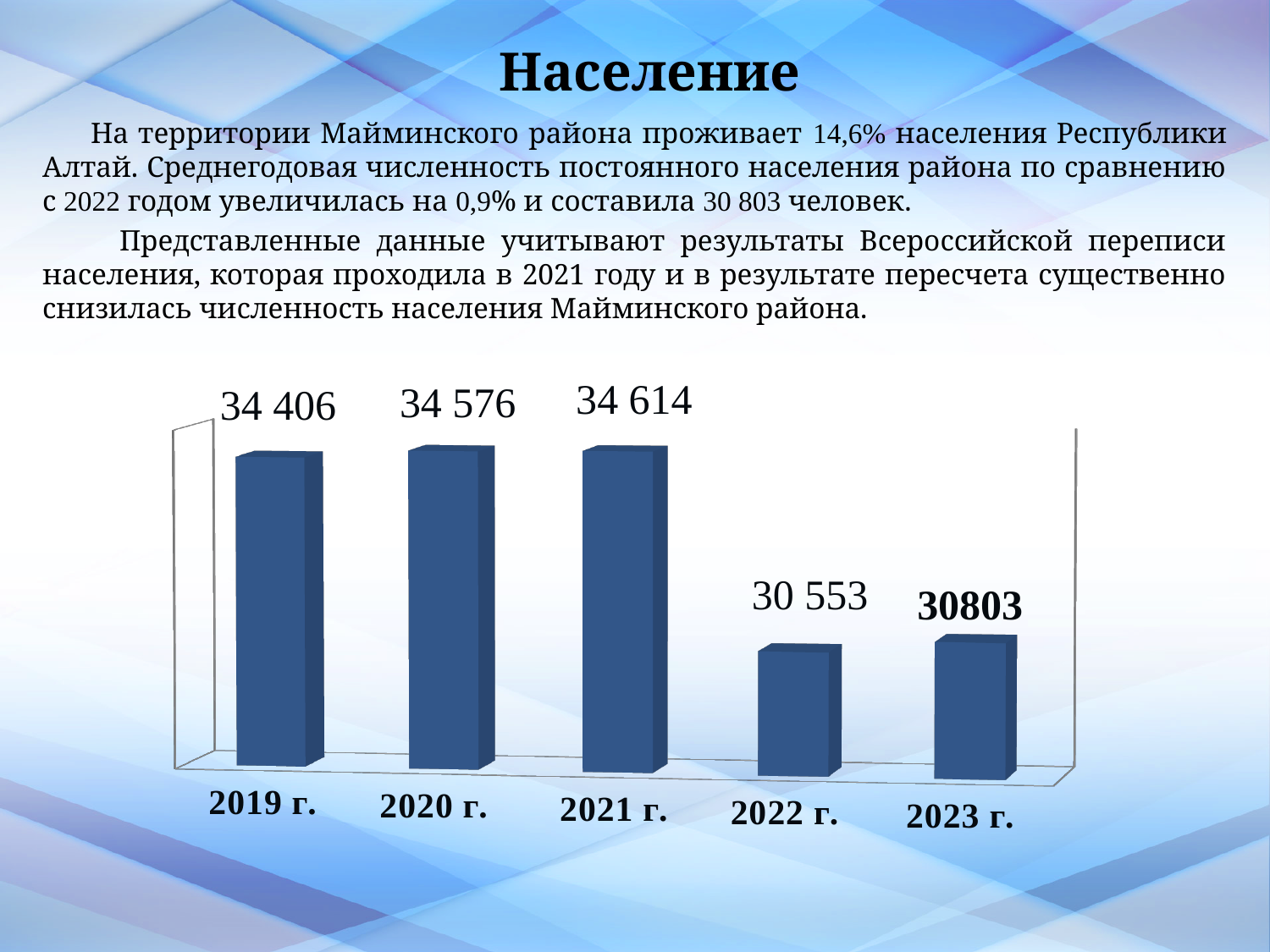
What is the difference between the values for 2021 г. and 2022 г.? 4 061 Which is larger, the value for 2020 г. or the value for 2023 г.? 2020 г. What is the value shown for 2021 г.? 34 614 Do the values rise or fall from 2021 г. to 2022 г.? fall What kind of chart is shown on the slide? bar chart What is the difference between the values for 2023 г. and 2022 г.? 250 Which year has the highest value on the chart? 2021 г. What is the value shown for 2022 г.? 30 553 How many years (bars) are shown on the chart? 5 Which year has the lowest value on the chart? 2022 г. What is the value shown for 2023 г.? 30803 What is the value shown for 2019 г.? 34 406